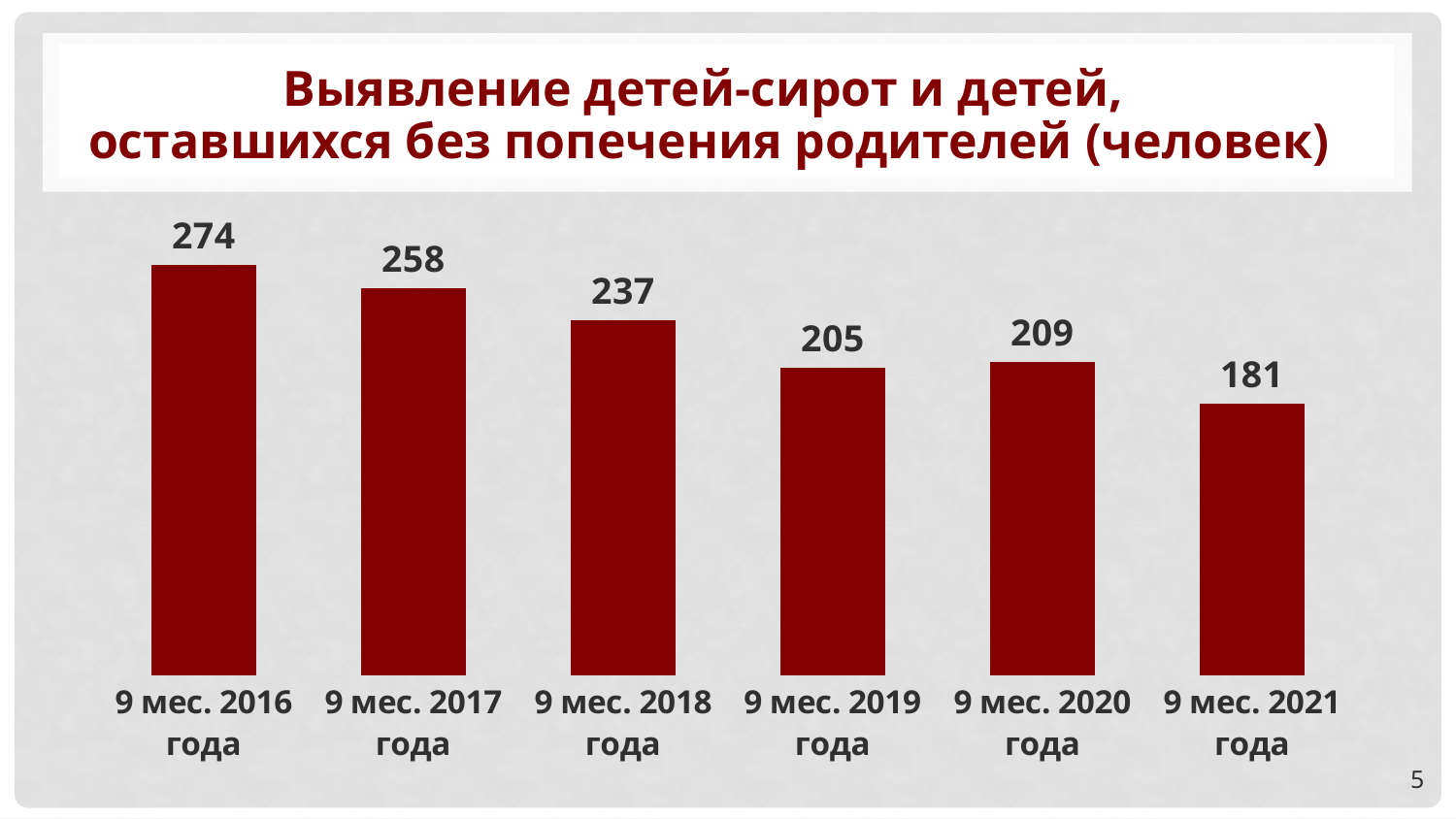
Do the values generally rise or fall from 9 мес. 2016 года to 9 мес. 2021 года? Fall What is the difference between the values for 9 мес. 2020 года and 9 мес. 2019 года? 4 Which period has the highest value? 9 мес. 2016 года Which is larger, the value for 9 мес. 2017 года or 9 мес. 2018 года? 9 мес. 2017 года Which period has the lowest value? 9 мес. 2021 года How many periods are shown on the chart? 6 What kind of chart is shown on the slide? Bar chart What is the title of the chart? Выявление детей-сирот и детей, оставшихся без попечения родителей (человек) What is the value for 9 мес. 2021 года? 181 What is the value for 9 мес. 2019 года? 205 What is the difference between the values for 9 мес. 2016 года and 9 мес. 2021 года? 93 What is the value for 9 мес. 2016 года? 274